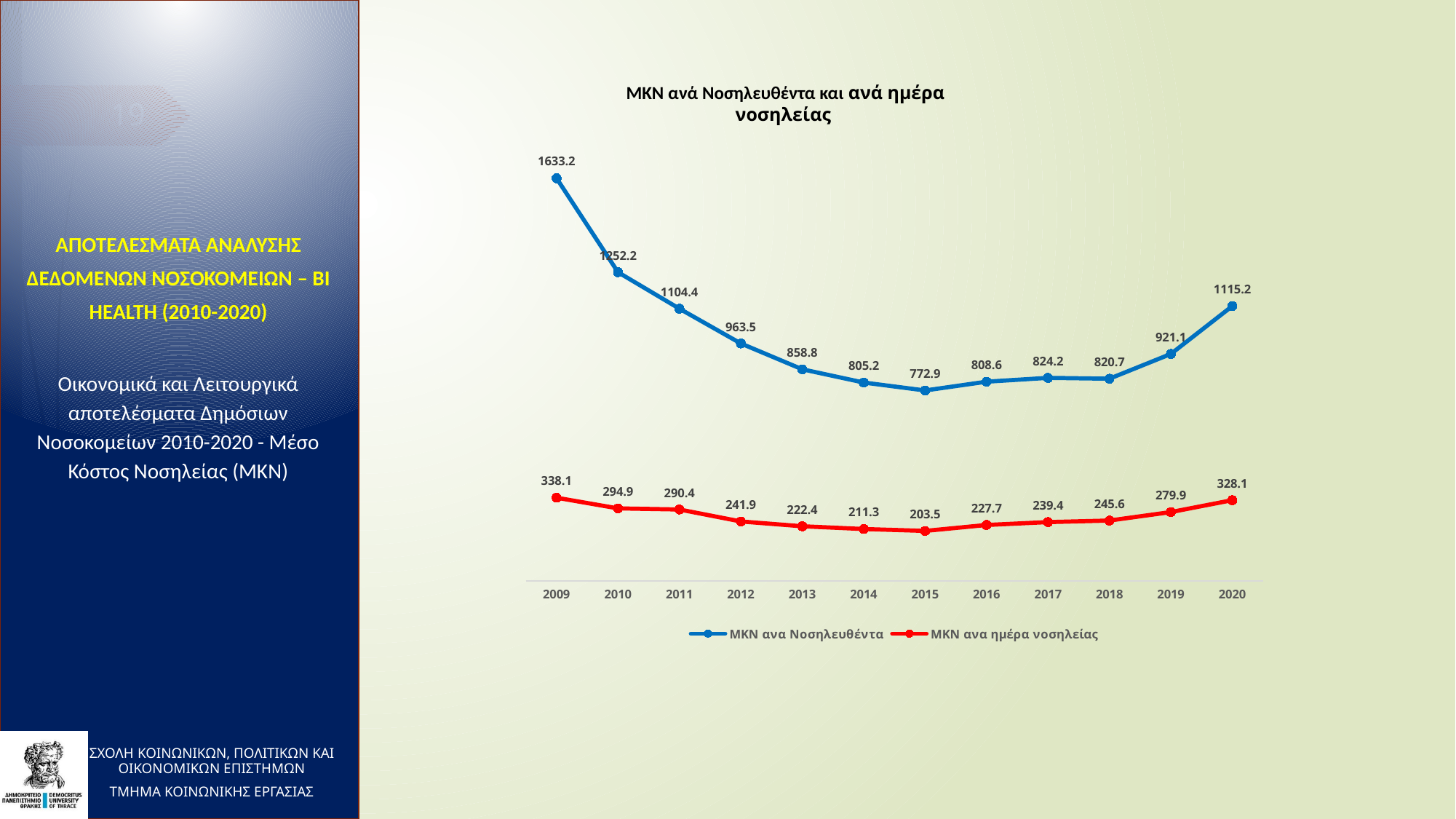
Which colour is used for the ΜΚΝ ανα ημέρα νοσηλείας series? Red How many series does the legend list? 2 What is the difference between ΜΚΝ ανα Νοσηλευθέντα in 2009 and in 2020? 518.0 In which year is ΜΚΝ ανα ημέρα νοσηλείας highest? 2009 What is the value of ΜΚΝ ανα ημέρα νοσηλείας in 2015? 203.5 How many years are shown on the x axis? 12 What is the value of ΜΚΝ ανα Νοσηλευθέντα in 2020? 1115.2 What is the difference between ΜΚΝ ανα ημέρα νοσηλείας in 2009 and in 2015? 134.6 Which is larger: ΜΚΝ ανα ημέρα νοσηλείας in 2019 or in 2018? 2019 What is the value of ΜΚΝ ανα Νοσηλευθέντα in 2009? 1633.2 What kind of chart is shown on the slide? Line chart In which year is ΜΚΝ ανα Νοσηλευθέντα lowest? 2015